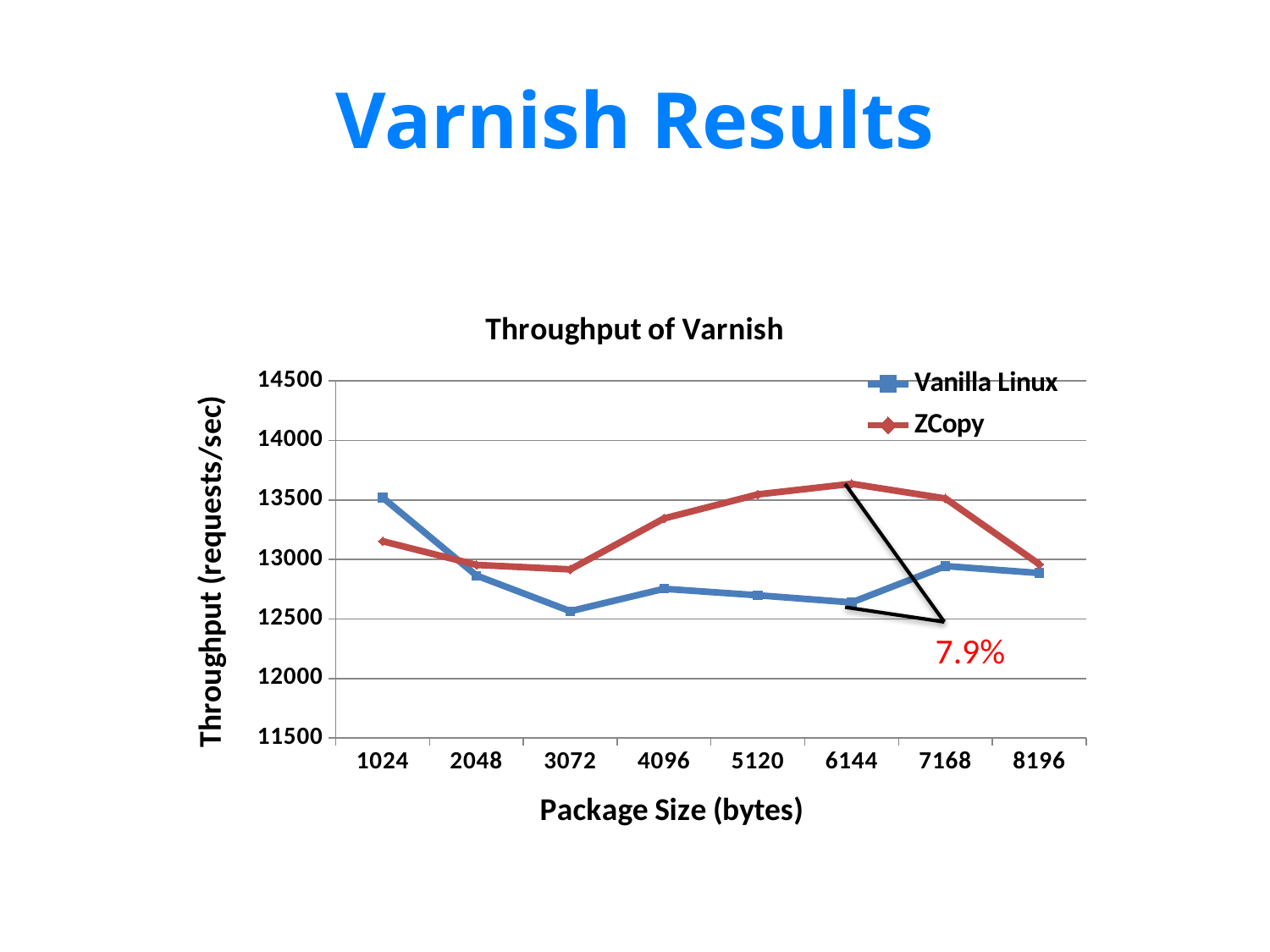
How many series does the legend list? 2 How many package sizes are plotted along the x axis? 8 What percentage is annotated in red on the chart? 7.9% What is the title of the chart? Throughput of Varnish At package size 6144, which series has the higher throughput, Vanilla Linux or ZCopy? ZCopy Is the ZCopy value at package size 5120 greater or less than 13000? greater What kind of chart is shown on the slide? line chart At which package size does the Vanilla Linux series reach its highest throughput? 1024 At package size 1024, which series has the higher throughput, Vanilla Linux or ZCopy? Vanilla Linux Is the Vanilla Linux value at package size 3072 greater or less than 13000? less Is the ZCopy value at package size 6144 greater or less than 13500? greater